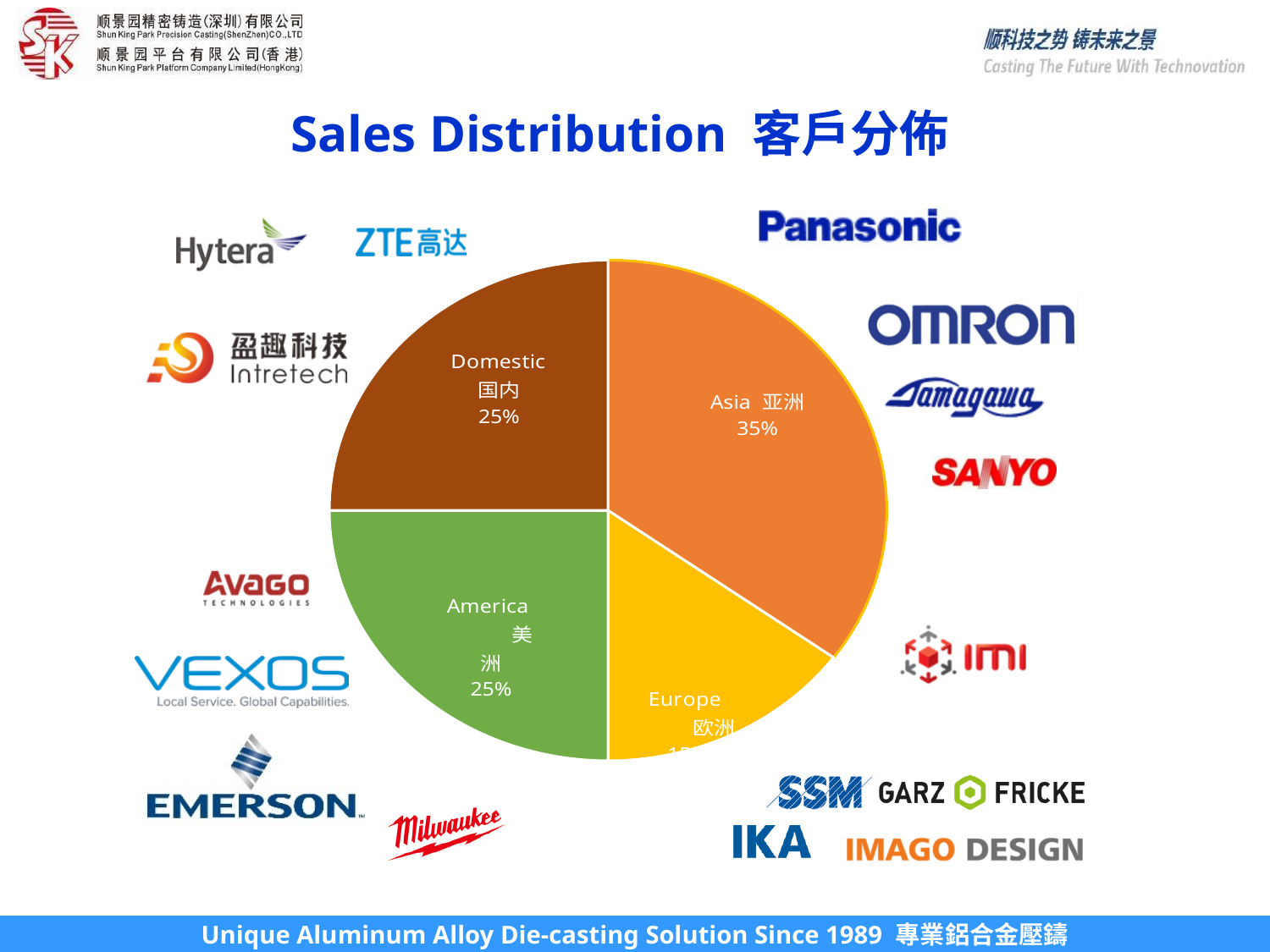
What is the title of the chart on the slide? Sales Distribution 客戶分佈 Which region has the smallest share of sales? Europe What is the difference between the Asia share and the Domestic share? 10% What percentage is shown for the Domestic slice? 25% Which region has the largest share of sales? Asia What percentage is shown for the America slice? 25% How many slices does the pie chart have? 4 Which is larger, the Asia share or the America share? Asia What type of chart is shown on the slide? pie chart Which is larger, the Domestic share or the Europe share? Domestic What share of sales does Asia account for? 35% What colour is the Asia slice of the pie chart? orange